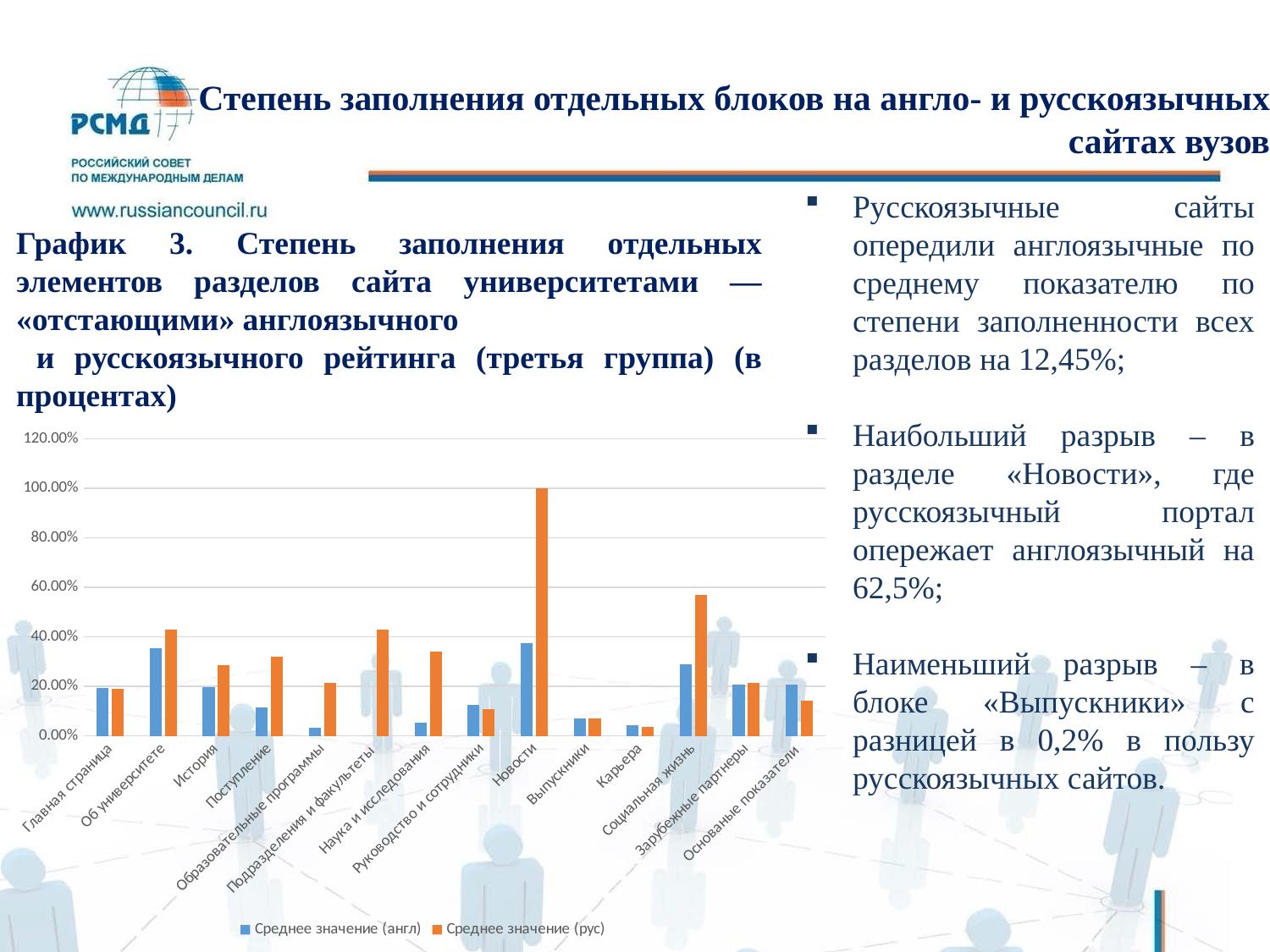
What colour are the bars for the series 'Среднее значение (рус)'? orange Is the value of 'Среднее значение (рус)' for Карьера greater or less than 20.00%? less How many categories are shown along the x axis of the chart? 14 Is the value of 'Среднее значение (рус)' for Социальная жизнь greater or less than 40.00%? greater Is the value of 'Среднее значение (англ)' for Об университете greater or less than 20.00%? greater Which category has the lowest value for the series 'Среднее значение (рус)'? Карьера For the category Основные показатели, which series has the larger value: 'Среднее значение (англ)' or 'Среднее значение (рус)'? Среднее значение (англ) What kind of chart is shown on the slide? bar chart How many series does the chart legend list? 2 Which category has the highest value for the series 'Среднее значение (рус)'? Новости For the category Новости, which series has the larger value: 'Среднее значение (англ)' or 'Среднее значение (рус)'? Среднее значение (рус)